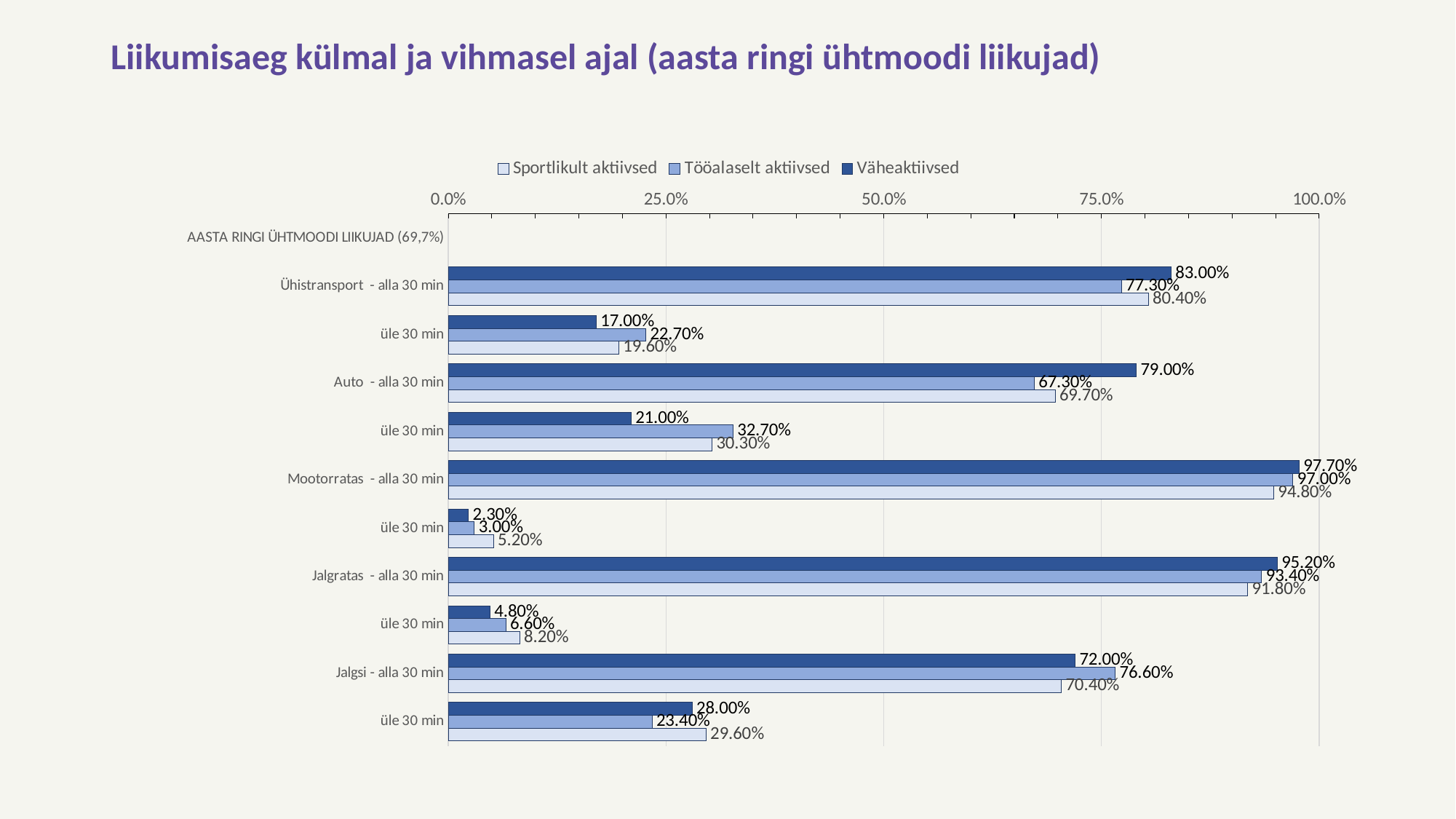
Which category has the lowest value for Tööalaselt aktiivsed? Mootorratas - üle 30 min In the Jalgsi - üle 30 min category, which is larger: Sportlikult aktiivsed or Tööalaselt aktiivsed? Sportlikult aktiivsed What is the title of the slide? Liikumisaeg külmal ja vihmasel ajal (aasta ringi ühtmoodi liikujad) What is the value for Tööalaselt aktiivsed in the Jalgsi - alla 30 min category? 76.60% Is the Väheaktiivsed value for Auto - üle 30 min greater or less than 25.0%? less What is the value for Sportlikult aktiivsed in the Auto - alla 30 min category? 69.70% What is the value for Sportlikult aktiivsed in the Mootorratas - üle 30 min category? 5.20% Which category has the highest value for Väheaktiivsed? Mootorratas - alla 30 min How many series does the legend list? 3 What kind of chart is shown on the slide? Bar chart What is the value for Väheaktiivsed in the Ühistransport - alla 30 min category? 83.00% What is the difference between the Väheaktiivsed and Tööalaselt aktiivsed values in the Auto - alla 30 min category? 11.70%